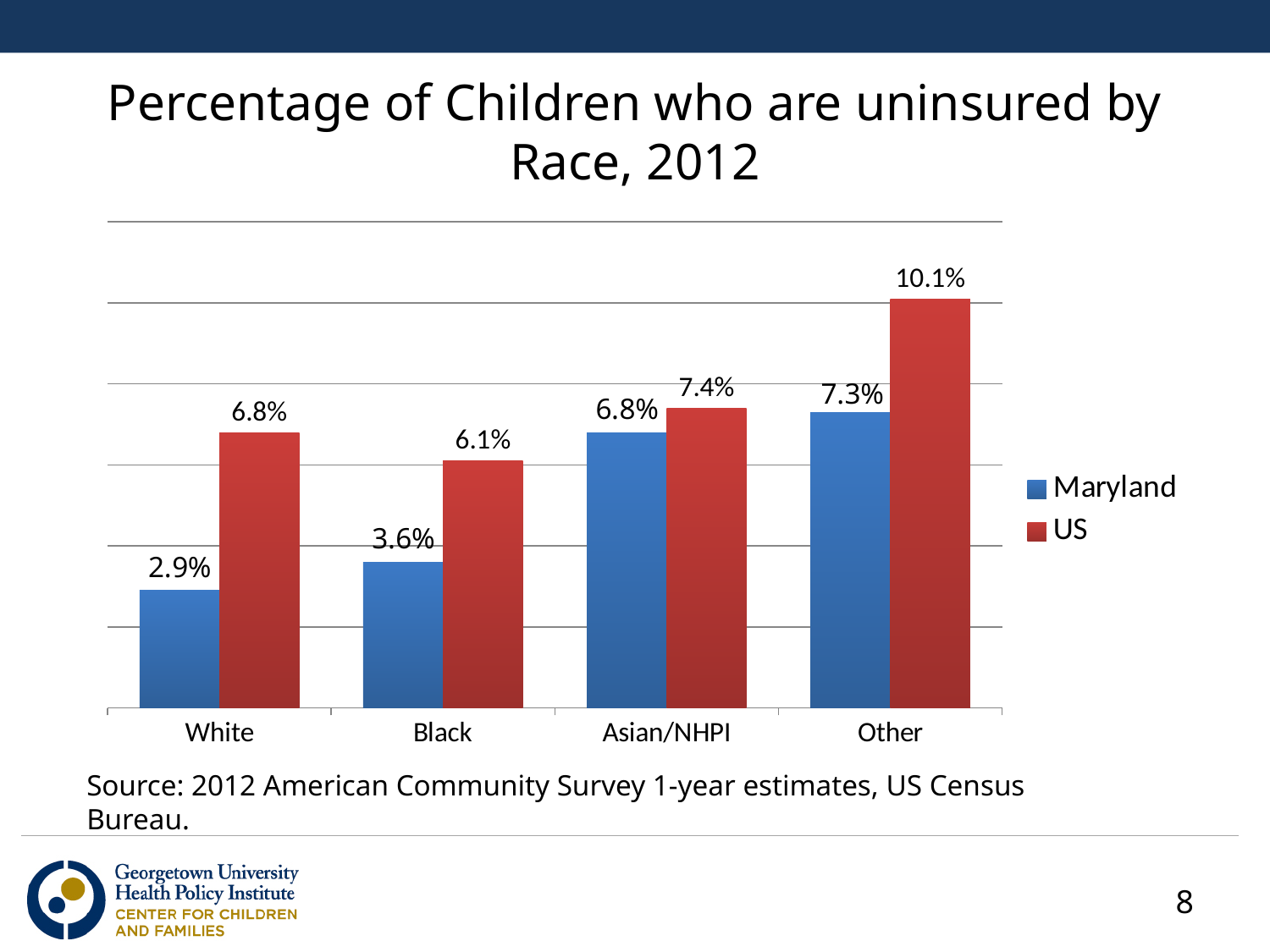
How many race categories are shown on the x axis? 4 What is the US value for Black children? 6.1% Which race category has the lowest Maryland value? White How many series does the legend list? 2 What is the Maryland value for Asian/NHPI children? 6.8% What is the US value for Other children? 10.1% What is the difference between the US and Maryland values for Other children? 2.8% What kind of chart is shown on the slide? Bar chart Which race category has the highest US value? Other What is the difference between the US and Maryland values for White children? 3.9% What is the Maryland value for White children? 2.9% Which is larger for Black children, the Maryland value or the US value? US